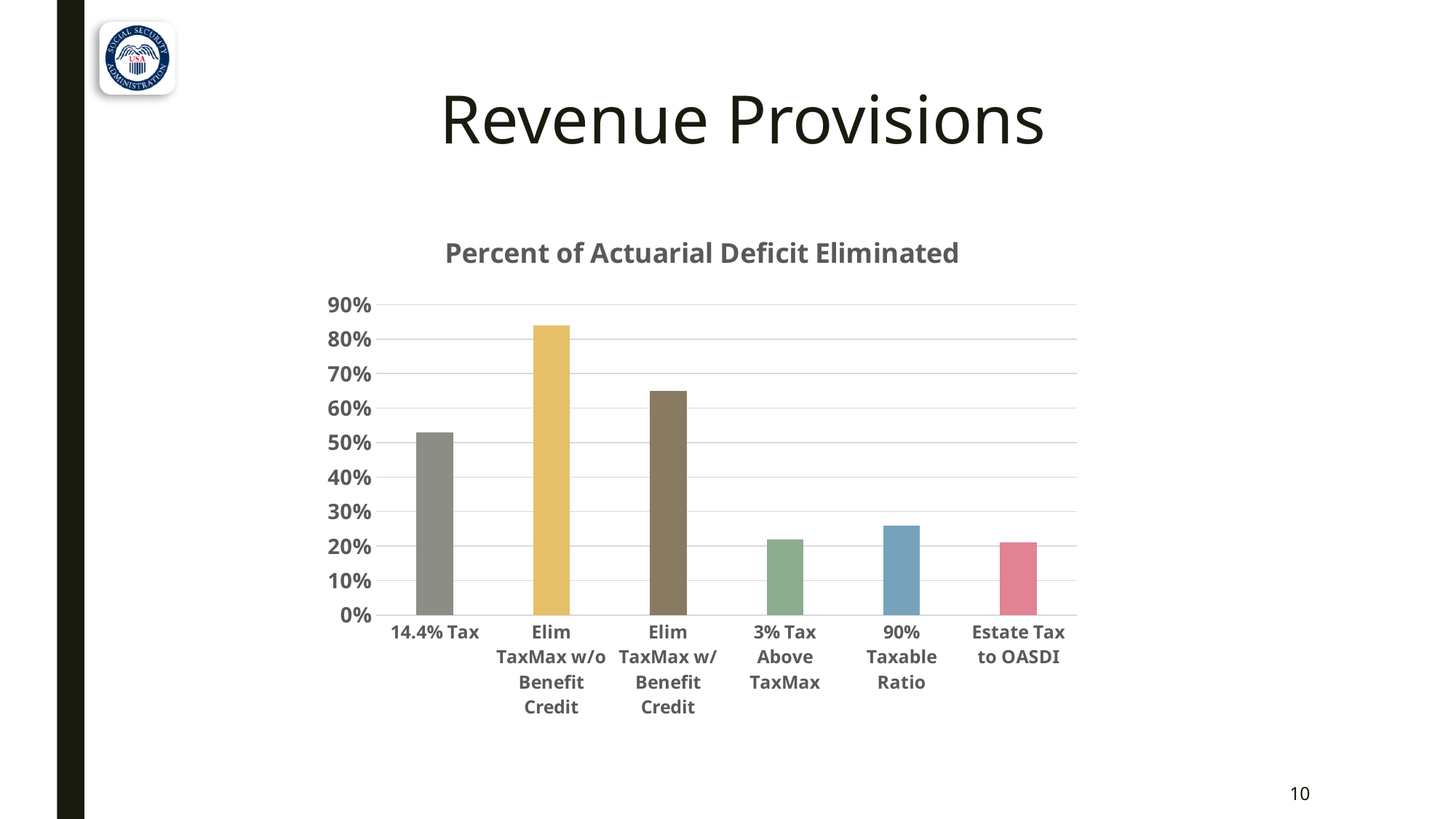
What is the title of the chart? Percent of Actuarial Deficit Eliminated Is the value for Elim TaxMax w/o Benefit Credit greater or less than 80%? greater Is the value for Elim TaxMax w/ Benefit Credit greater or less than 70%? less Is the value for Estate Tax to OASDI greater or less than 30%? less Which is larger, the value for 14.4% Tax or the value for Elim TaxMax w/ Benefit Credit? Elim TaxMax w/ Benefit Credit What type of chart is shown on the slide? bar chart Which is larger, the value for 14.4% Tax or the value for 90% Taxable Ratio? 14.4% Tax Which provision eliminates the highest percent of the actuarial deficit? Elim TaxMax w/o Benefit Credit How many revenue provisions (bars) are shown in the chart? 6